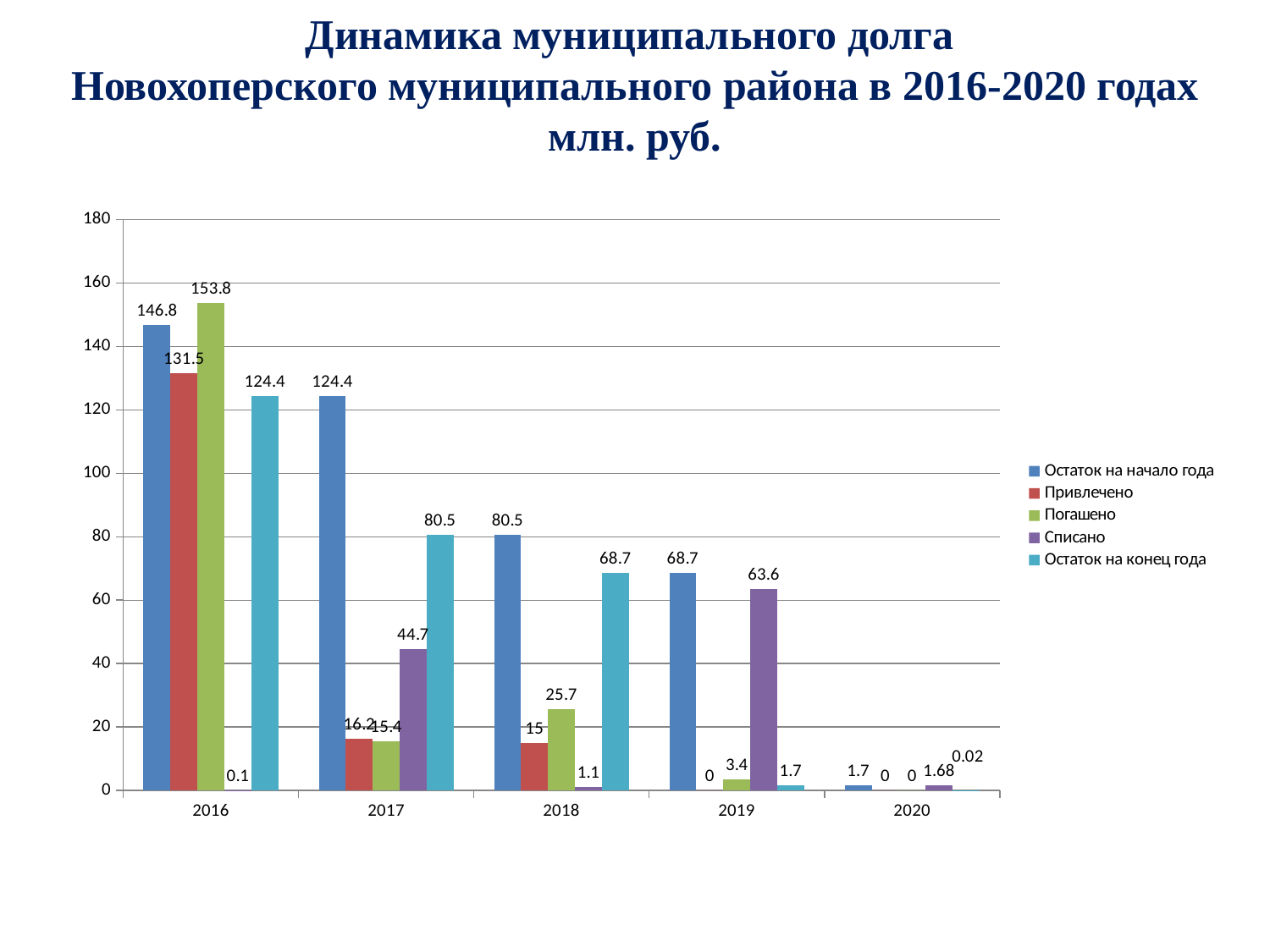
What is the value of "Списано" in 2020? 1.68 What is the value of "Остаток на конец года" in 2018? 68.7 What is the value of "Списано" in 2017? 44.7 How many years are shown on the x axis? 5 Does "Остаток на начало года" rise or fall from 2016 to 2020? Fall In which year is "Остаток на конец года" the lowest? 2020 How many series does the legend list? 5 In which year is "Остаток на начало года" the highest? 2016 What is the difference between "Остаток на начало года" and "Остаток на конец года" in 2017? 43.9 Which is larger in 2019: "Списано" or "Погашено"? Списано What is the value of "Погашено" in 2016? 153.8 What type of chart is shown on the slide? Bar chart